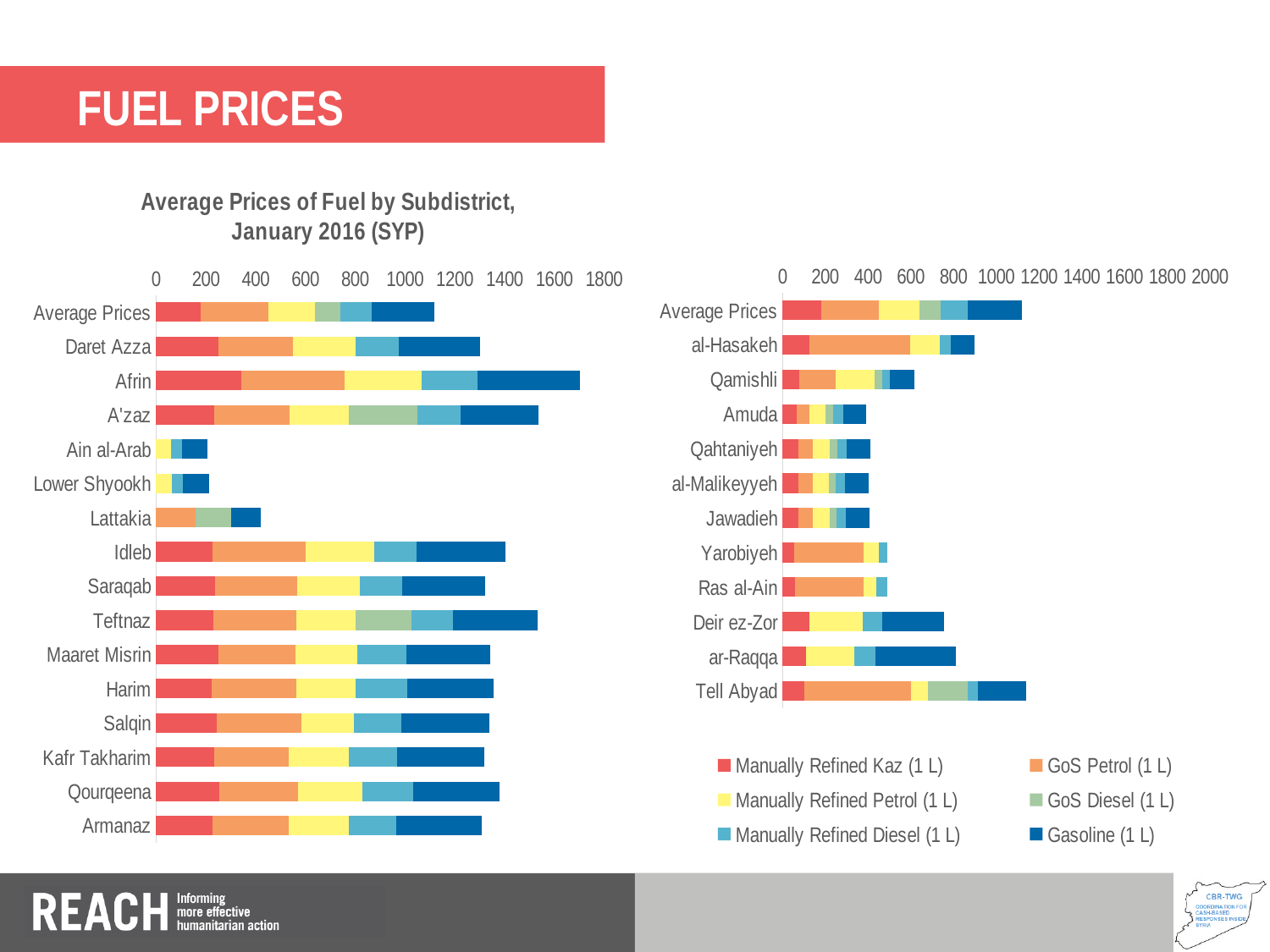
On the right chart, is the total bar for Qamishli greater or less than 800? less On the right chart, which has the longer total bar, al-Hasakeh or Qamishli? al-Hasakeh On the left chart, is the total bar for Afrin greater or less than 1600? greater How many categories (including Average Prices) are plotted on the right chart? 12 On the left chart, which has the longer total bar, Teftnaz or Saraqab? Teftnaz Which legend entry is shown in dark blue? Gasoline (1 L) On the left chart, which subdistrict has the longest total bar? Afrin How many subdistrict categories (including Average Prices) are plotted on the left chart? 16 On the left chart, is the total bar for Lattakia greater or less than 600? less What kind of chart is the left chart, 'Average Prices of Fuel by Subdistrict, January 2016 (SYP)'? Stacked bar chart How many series does the legend list for the charts? 6